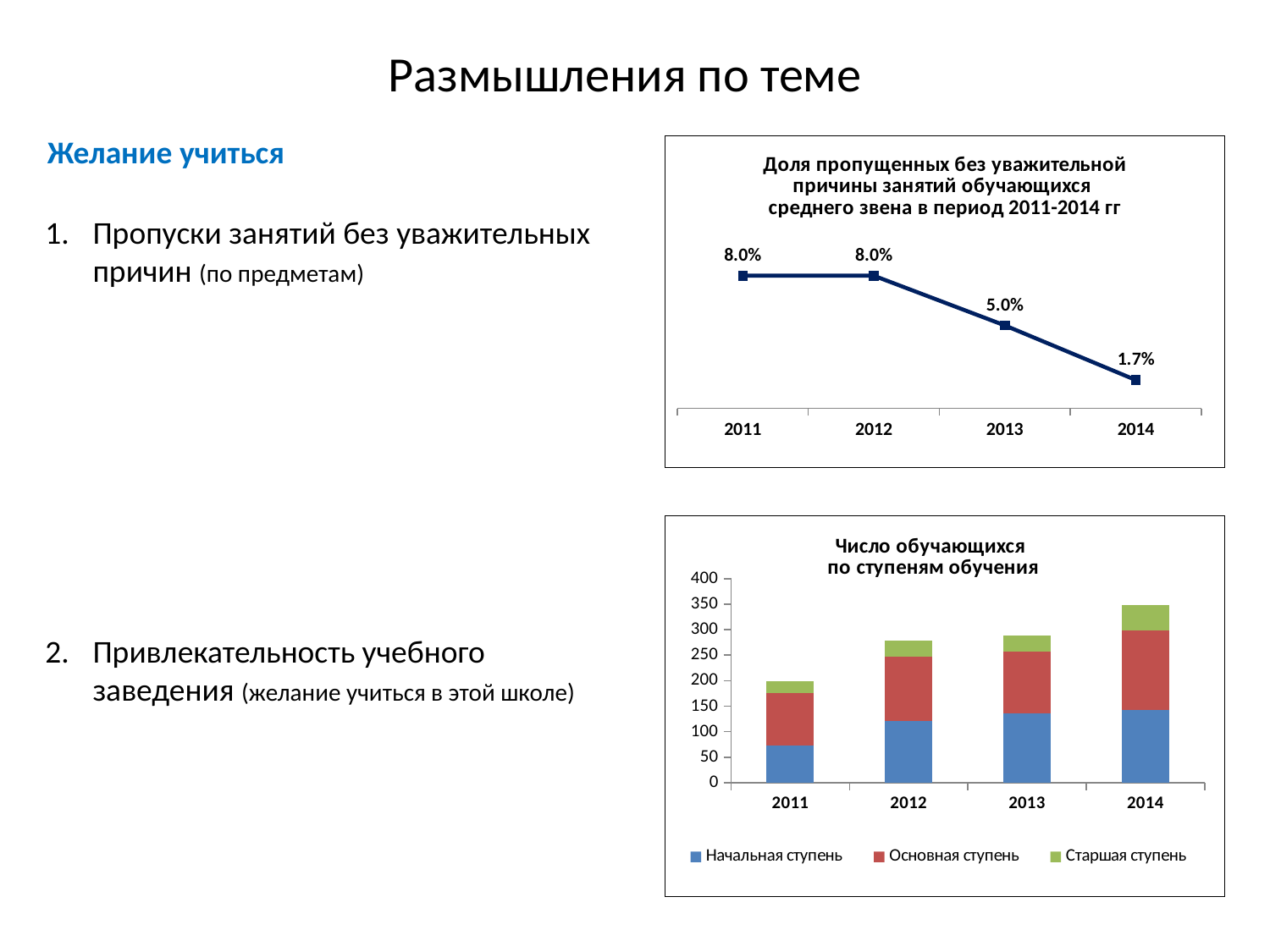
How many years are plotted in the top chart (Доля пропущенных без уважительной причины занятий)? 4 What kind of chart is the top chart on the slide? line chart In the bottom chart (Число обучающихся по ступеням обучения), is the total height of the 2014 bar greater or less than 300? greater In the bottom chart (Число обучающихся по ступеням обучения), which year has the taller total bar, 2011 or 2014? 2014 How many series does the legend of the bottom chart (Число обучающихся по ступеням обучения) list? 3 What kind of chart is the bottom chart (Число обучающихся по ступеням обучения)? stacked bar chart In the top chart (Доля пропущенных без уважительной причины занятий), do the values rise or fall from 2011 to 2014? fall In the top chart (Доля пропущенных без уважительной причины занятий), what is the value for 2013? 5.0% In the top chart (Доля пропущенных без уважительной причины занятий), which year has the lowest value? 2014 In the top chart (Доля пропущенных без уважительной причины занятий), what is the value for 2014? 1.7% In the bottom chart (Число обучающихся по ступеням обучения), which series is shown in green? Старшая ступень In the top chart (Доля пропущенных без уважительной причины занятий), what is the difference between the 2011 value and the 2014 value? 6.3%